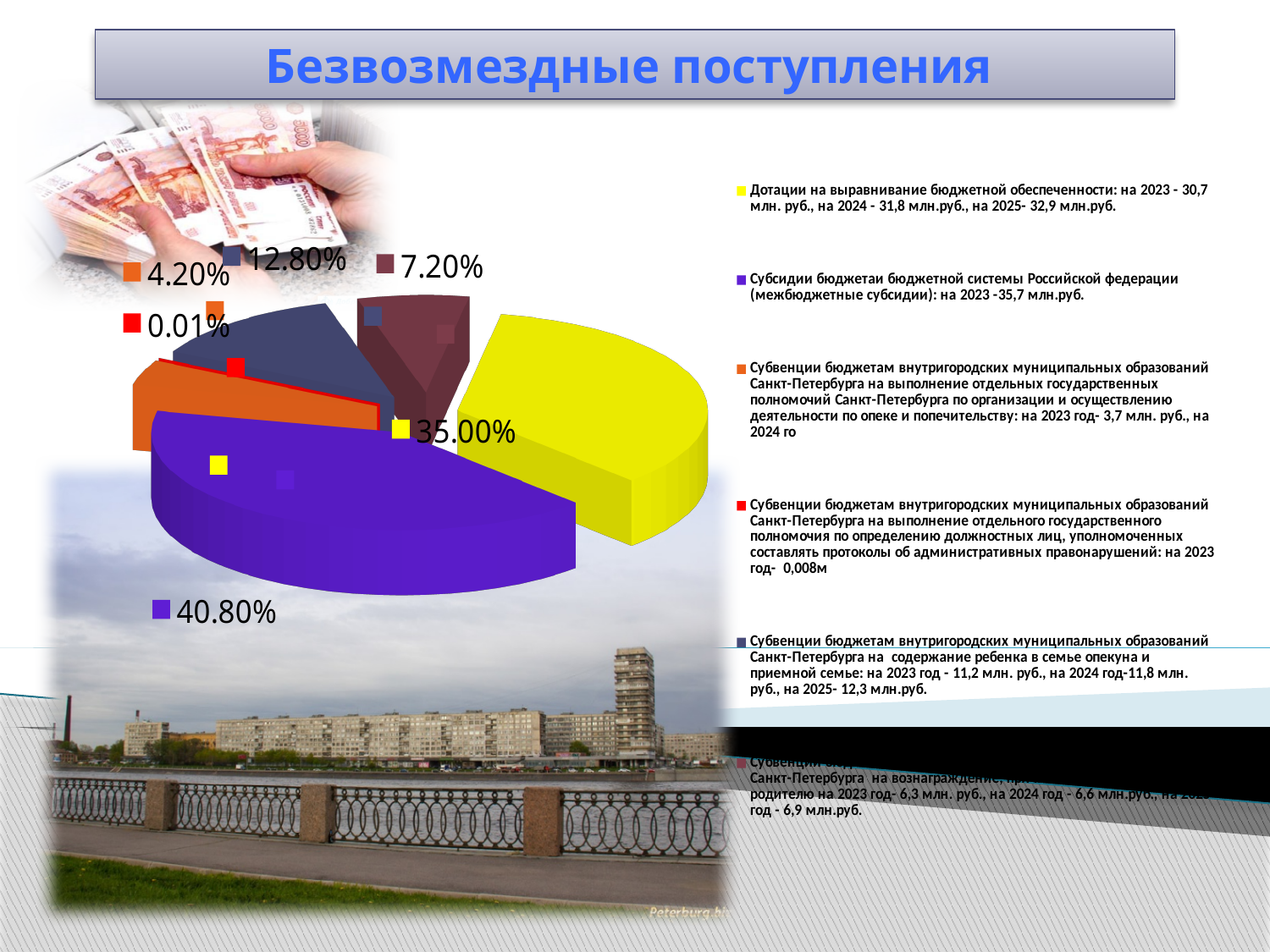
What percentage is shown for the orange slice (Субвенции на деятельность по опеке и попечительству)? 4.20% What kind of chart is shown on the slide? pie chart What is the difference between the purple slice (40.80%) and the yellow slice (35.00%)? 5.80% How many slices does the pie chart have? 6 What percentage is shown for the dark red (maroon) slice of the pie chart? 7.20% What percentage is shown for the slate-blue slice (Субвенции на содержание ребенка в семье опекуна и приемной семье)? 12.80% Which slice of the pie chart is the largest? Субсидии бюджетам бюджетной системы Российской федерации (40.80%) What share of the pie does the yellow slice (Дотации на выравнивание бюджетной обеспеченности) represent? 35.00% Which slice of the pie chart is the smallest? Субвенции на определение должностных лиц, уполномоченных составлять протоколы об административных правонарушениях (0.01%) What is the title of the slide containing the pie chart? Безвозмездные поступления What percentage is shown for the red slice (Субвенции на определение должностных лиц, уполномоченных составлять протоколы об административных правонарушениях)? 0.01% What share of the pie does the purple slice (Субсидии бюджетам бюджетной системы Российской федерации) represent? 40.80%